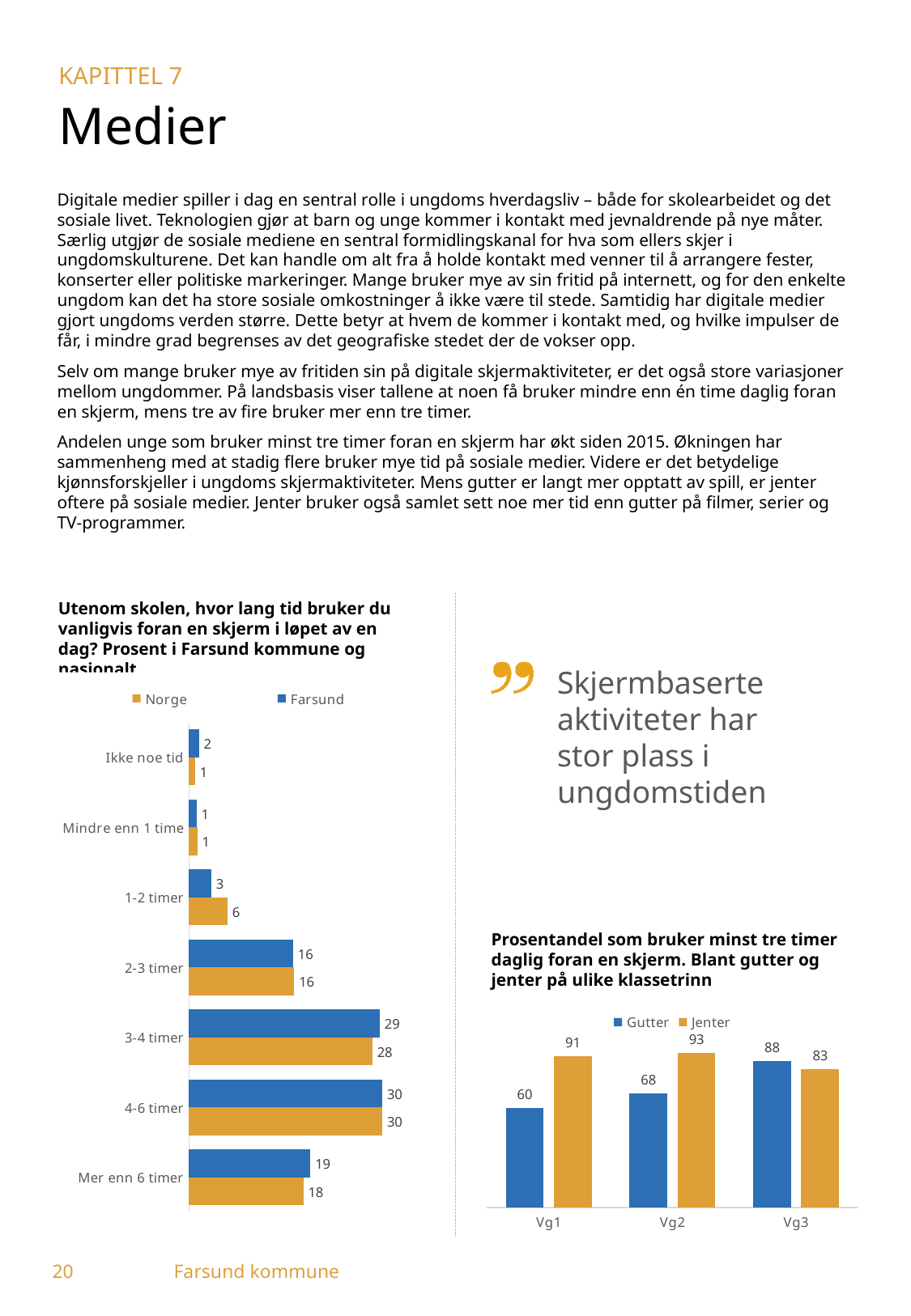
In the chart on the left (Utenom skolen, hvor lang tid bruker du vanligvis foran en skjerm...), what is the Farsund value for '3-4 timer'? 29 In the chart on the right (Prosentandel som bruker minst tre timer daglig foran en skjerm), what is the Jenter value for Vg2? 93 In the chart on the right (Prosentandel som bruker minst tre timer...), what is the Gutter value for Vg1? 60 What kind of chart is the chart on the left (Utenom skolen...)? Bar chart In the chart on the right (Prosentandel som bruker minst tre timer...), what is the difference between Jenter and Gutter for Vg1? 31 In the chart on the right (Prosentandel som bruker minst tre timer...), which is larger for Vg3, Gutter or Jenter? Gutter In the chart on the left (Utenom skolen...), how many series does the legend list? 2 In the chart on the left (Utenom skolen...), what is the difference between the Norge and Farsund values for '1-2 timer'? 3 In the chart on the left (Utenom skolen...), what is the Norge value for '1-2 timer'? 6 In the chart on the left (Utenom skolen...), how many categories are shown? 7 In the chart on the right (Prosentandel som bruker minst tre timer...), do the Gutter values rise or fall from Vg1 to Vg3? Rise In the chart on the left (Utenom skolen...), which category has the highest Farsund value? 4-6 timer